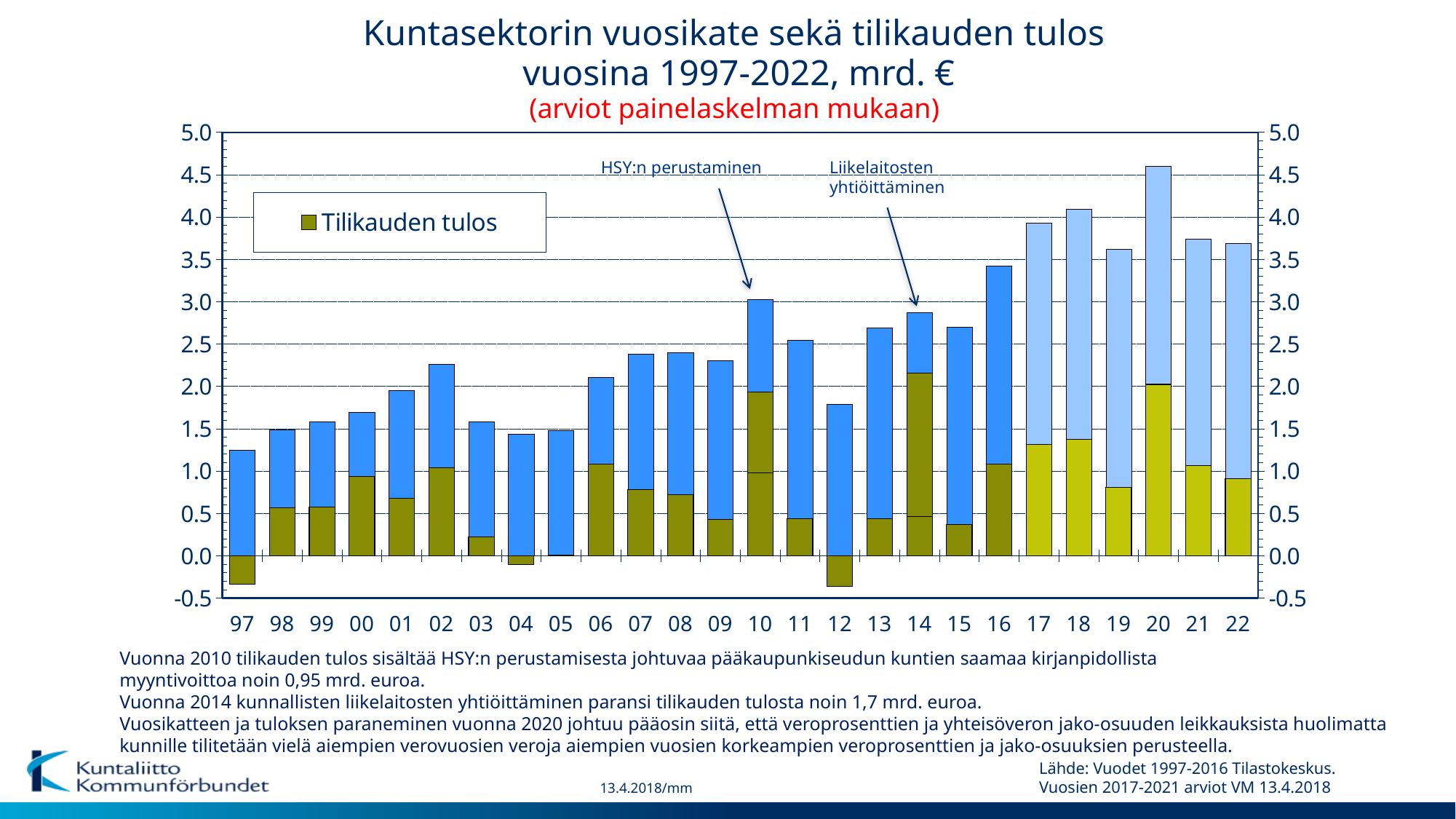
Which year has the highest vuosikate (total bar height) in the chart? 20 How many years are shown on the x axis of the chart? 26 What is the series name shown in the chart legend? Tilikauden tulos What kind of chart is shown on the slide? bar chart How many series does the legend of the chart list? 1 Is the tilikauden tulos for year 14 greater or less than 2.0? greater Which year has the larger vuosikate (total bar), 18 or 19? 18 Is the vuosikate (total bar) for year 20 greater or less than 4.0? greater Is the tilikauden tulos for year 12 greater or less than 0.0? less Overall, do the vuosikate bars rise or fall from 97 to 22? rise Which year has the lowest vuosikate (total bar height) in the chart? 97